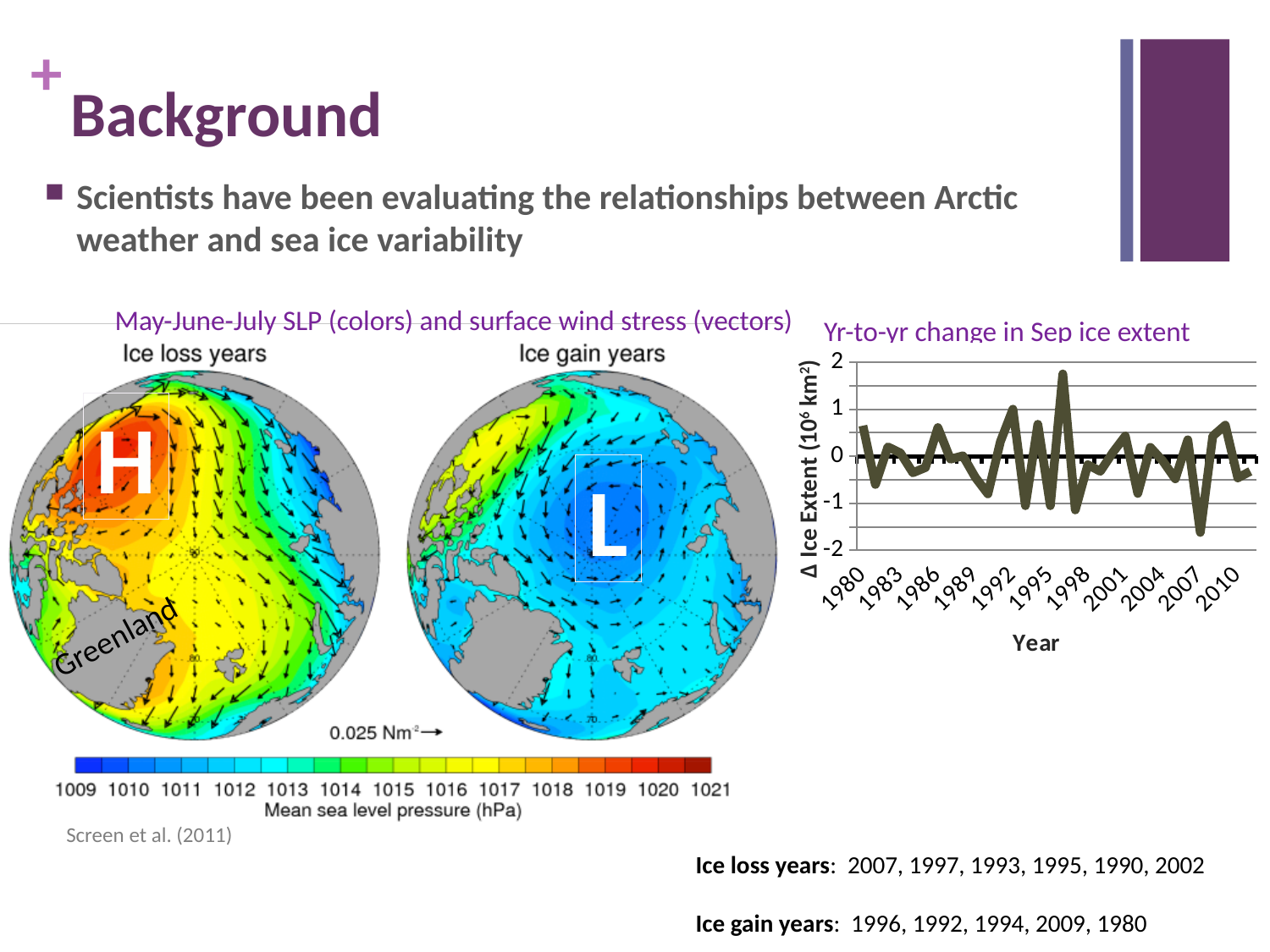
In the 'Yr-to-yr change in Sep ice extent' chart, which is larger, the value for 1996 or the value for 2007? 1996 In the 'Yr-to-yr change in Sep ice extent' chart, is the value for 1992 greater or less than 0? greater How many year labels are shown on the x axis of the 'Yr-to-yr change in Sep ice extent' chart? 11 In the 'Yr-to-yr change in Sep ice extent' chart, what is the label on the vertical axis? Δ Ice Extent (10⁶ km²) What is the title of the chart on the right side of the slide? Yr-to-yr change in Sep ice extent In the 'Yr-to-yr change in Sep ice extent' chart, is the value for 2007 greater or less than -1? less In the 'Yr-to-yr change in Sep ice extent' chart, which year has the highest value? 1996 In the 'Yr-to-yr change in Sep ice extent' chart, is the value for 1996 greater or less than 1? greater What kind of chart is the 'Yr-to-yr change in Sep ice extent' chart? line chart In the 'Yr-to-yr change in Sep ice extent' chart, what are the lowest and highest values marked on the vertical axis? -2 and 2 In the 'Yr-to-yr change in Sep ice extent' chart, which is larger, the value for 1992 or the value for 1993? 1992 In the 'Yr-to-yr change in Sep ice extent' chart, which year has the lowest value? 2007